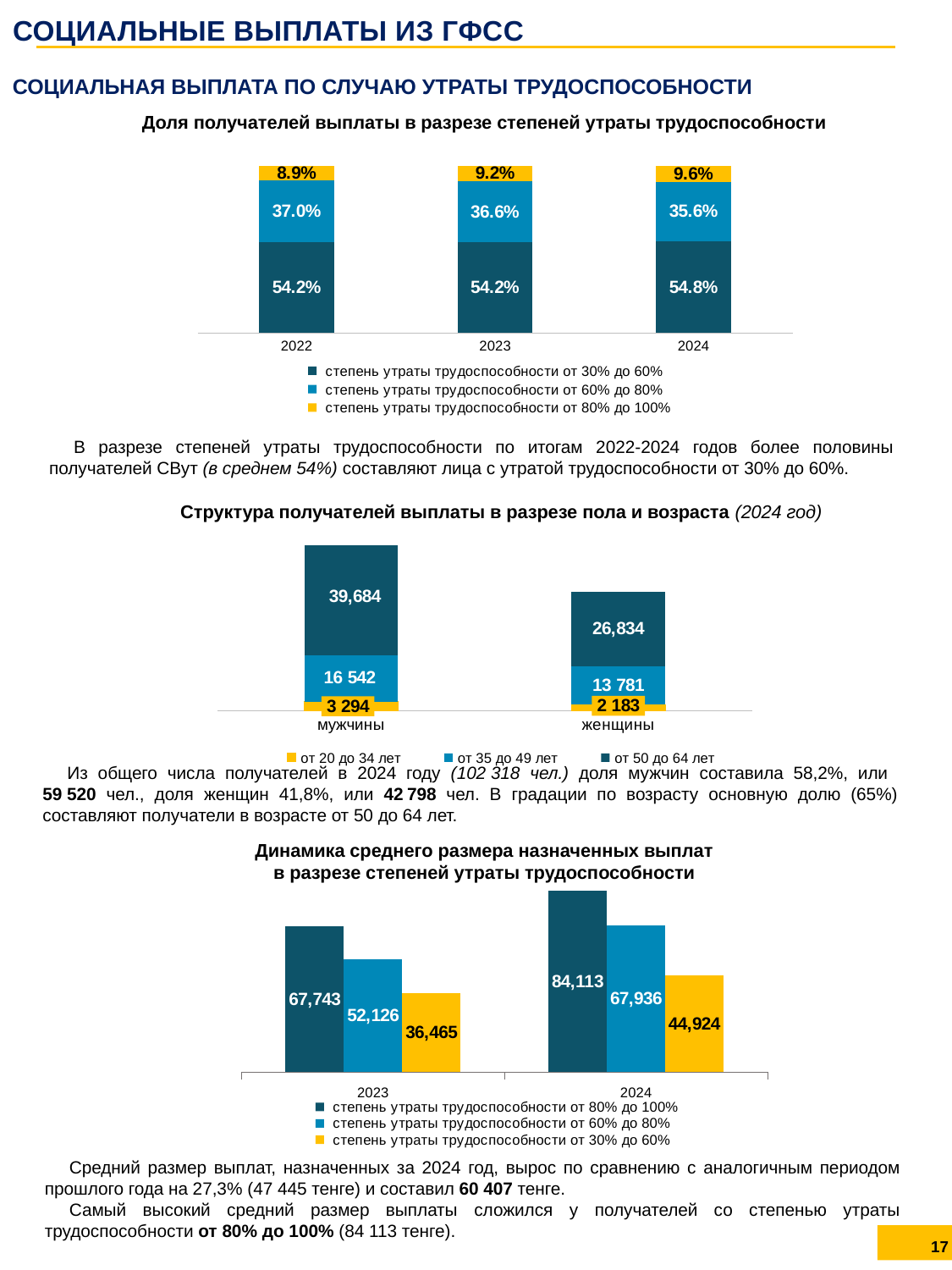
In the chart 'Доля получателей выплаты в разрезе степеней утраты трудоспособности', what is the share for 'степень утраты трудоспособности от 30% до 60%' in 2024? 54.8% How many series does the legend of the chart 'Доля получателей выплаты в разрезе степеней утраты трудоспособности' list? 3 In the chart 'Структура получателей выплаты в разрезе пола и возраста (2024 год)', what is the value for 'от 50 до 64 лет' for мужчины? 39,684 In the chart 'Доля получателей выплаты в разрезе степеней утраты трудоспособности', what is the share for 'степень утраты трудоспособности от 80% до 100%' in 2022? 8.9% In the chart 'Доля получателей выплаты в разрезе степеней утраты трудоспособности', does the share for 'степень утраты трудоспособности от 80% до 100%' rise or fall from 2022 to 2024? rise In the chart 'Структура получателей выплаты в разрезе пола и возраста (2024 год)', what is the value for 'от 20 до 34 лет' for женщины? 2 183 In the chart 'Динамика среднего размера назначенных выплат в разрезе степеней утраты трудоспособности', which series has the lowest value in 2023? степень утраты трудоспособности от 30% до 60% In the chart 'Структура получателей выплаты в разрезе пола и возраста (2024 год)', how many categories are shown on the x axis? 2 In the chart 'Динамика среднего размера назначенных выплат в разрезе степеней утраты трудоспособности', what is the value for 'степень утраты трудоспособности от 60% до 80%' in 2024? 67,936 In the chart 'Динамика среднего размера назначенных выплат в разрезе степеней утраты трудоспособности', what is the difference between the 2024 and 2023 values for 'степень утраты трудоспособности от 30% до 60%'? 8,459 What kind of chart is 'Динамика среднего размера назначенных выплат в разрезе степеней утраты трудоспособности'? bar chart In the chart 'Структура получателей выплаты в разрезе пола и возраста (2024 год)', which age group is the largest for женщины? от 50 до 64 лет